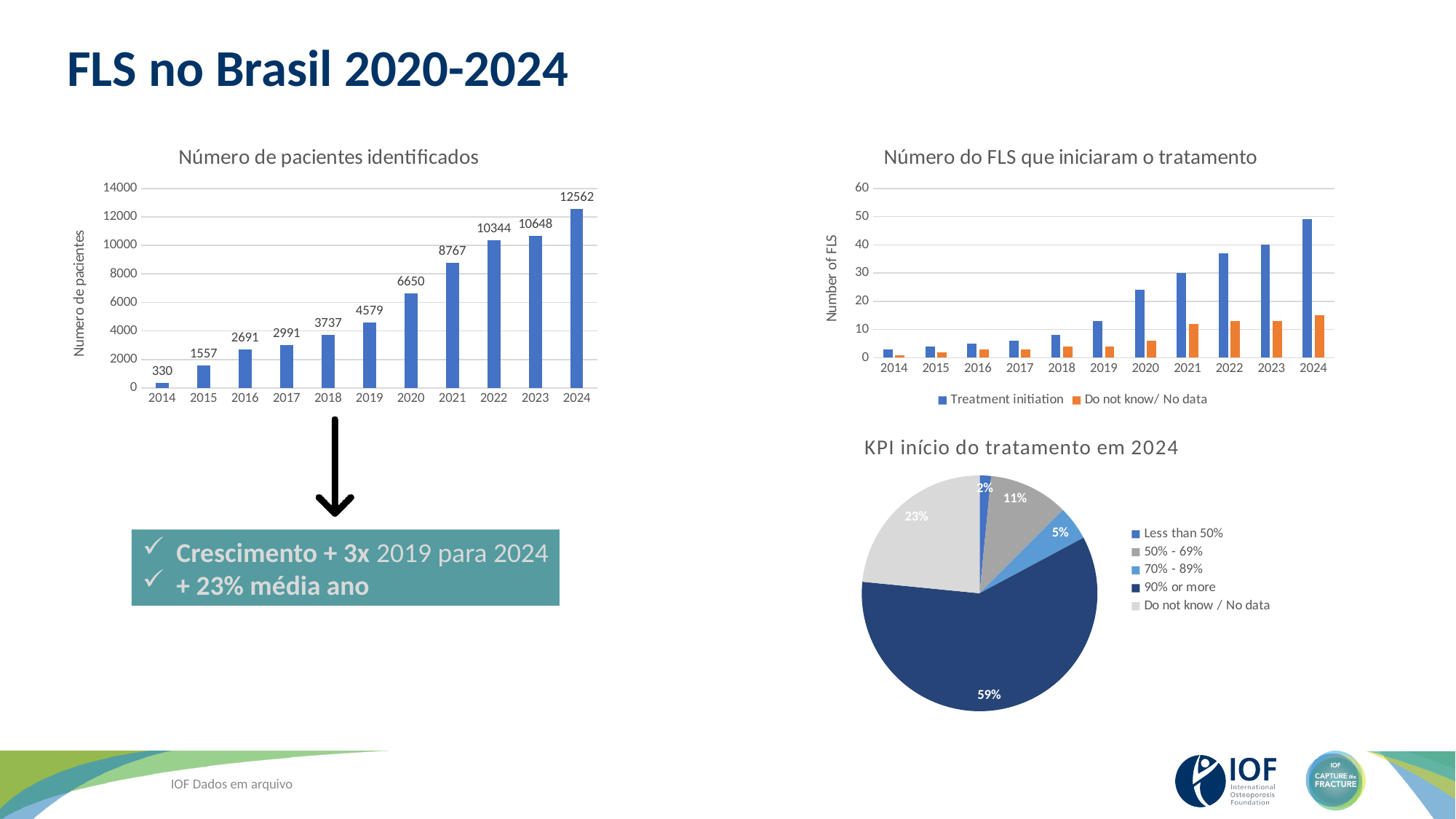
In the chart 'Número do FLS que iniciaram o tratamento', is the value for Treatment initiation in 2022 greater or less than 30? greater In the chart 'Número de pacientes identificados', which year has the lowest value? 2014 In the chart 'Número do FLS que iniciaram o tratamento', how many series does the legend list? 2 In the chart 'Número do FLS que iniciaram o tratamento', is the value for Do not know/ No data in 2024 greater or less than 10? greater In the chart 'Número do FLS que iniciaram o tratamento', which year has the highest Treatment initiation value? 2024 In the chart 'Número de pacientes identificados', what is the value for 2024? 12562 In the chart 'Número de pacientes identificados', what is the value for 2019? 4579 In the chart 'KPI início do tratamento em 2024', what share does '90% or more' have? 59% In the chart 'Número de pacientes identificados', do the values rise or fall from 2014 to 2024? rise In the chart 'Número de pacientes identificados', what is the difference between the values for 2024 and 2023? 1914 In the chart 'Número de pacientes identificados', how many years are shown on the x axis? 11 What kind of chart is 'KPI início do tratamento em 2024'? pie chart